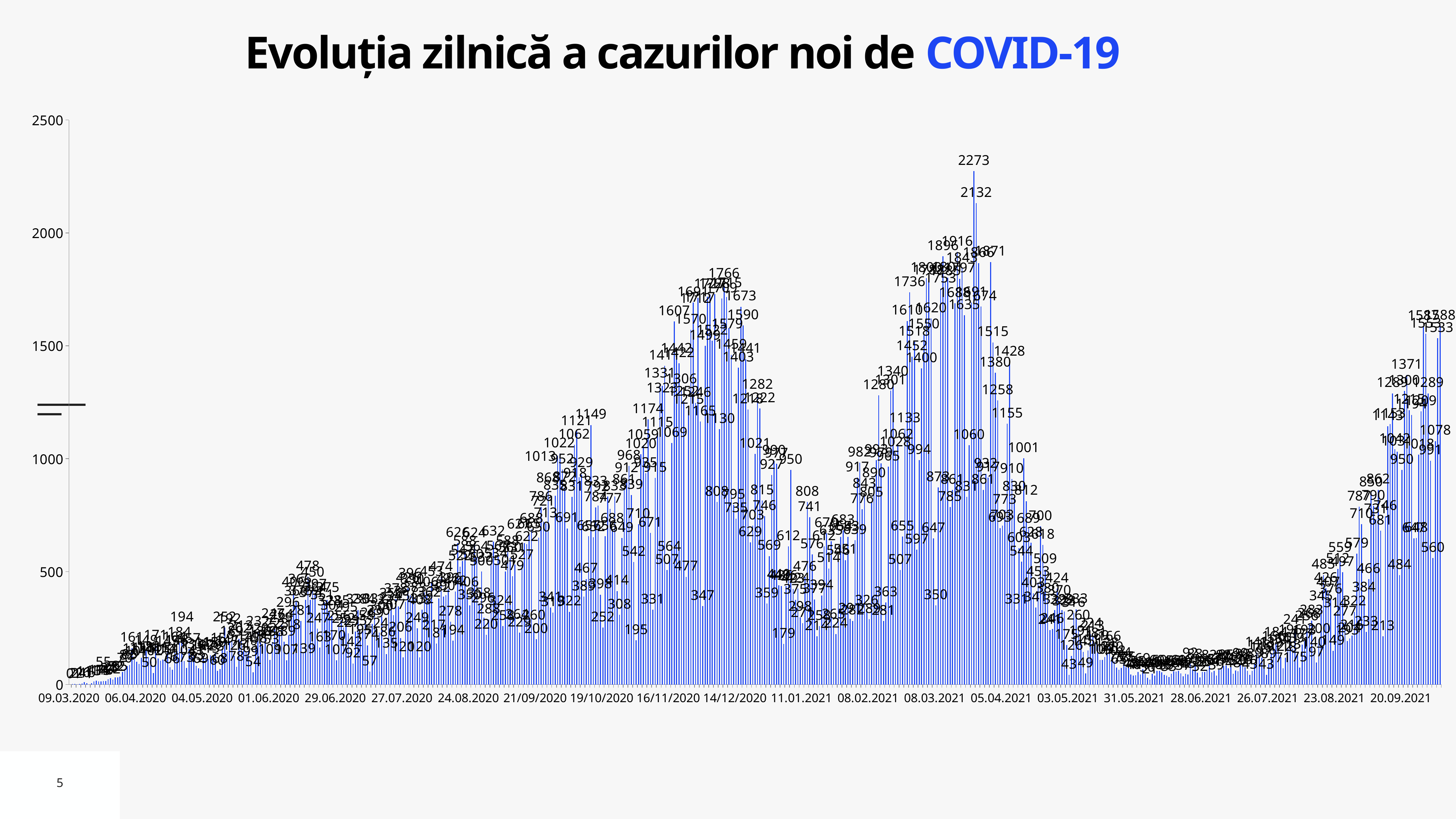
What is the maximum value shown on the vertical axis? 2500 What is the title of the chart? Evoluția zilnică a cazurilor noi de COVID-19 What is the difference between the two highest labelled values, 2273 and 2132? 141 What is the second-highest value labelled on the chart, next to the 2273 peak? 2132 Do the values rise or fall between 26.07.2021 and 20.09.2021? rise Is the highest bar on the chart greater or less than 2000? greater What is the highest daily value labelled on the chart? 2273 What kind of chart is shown on the slide? bar chart Which is larger: the peak value around 05.04.2021 (2273) or the peak value around 14.12.2020 (1766)? 2273 (around 05.04.2021) Do the values rise or fall between 05.04.2021 and 31.05.2021? fall Are the values around 31.05.2021 greater or less than 500? less How many date labels are shown along the horizontal axis? 21